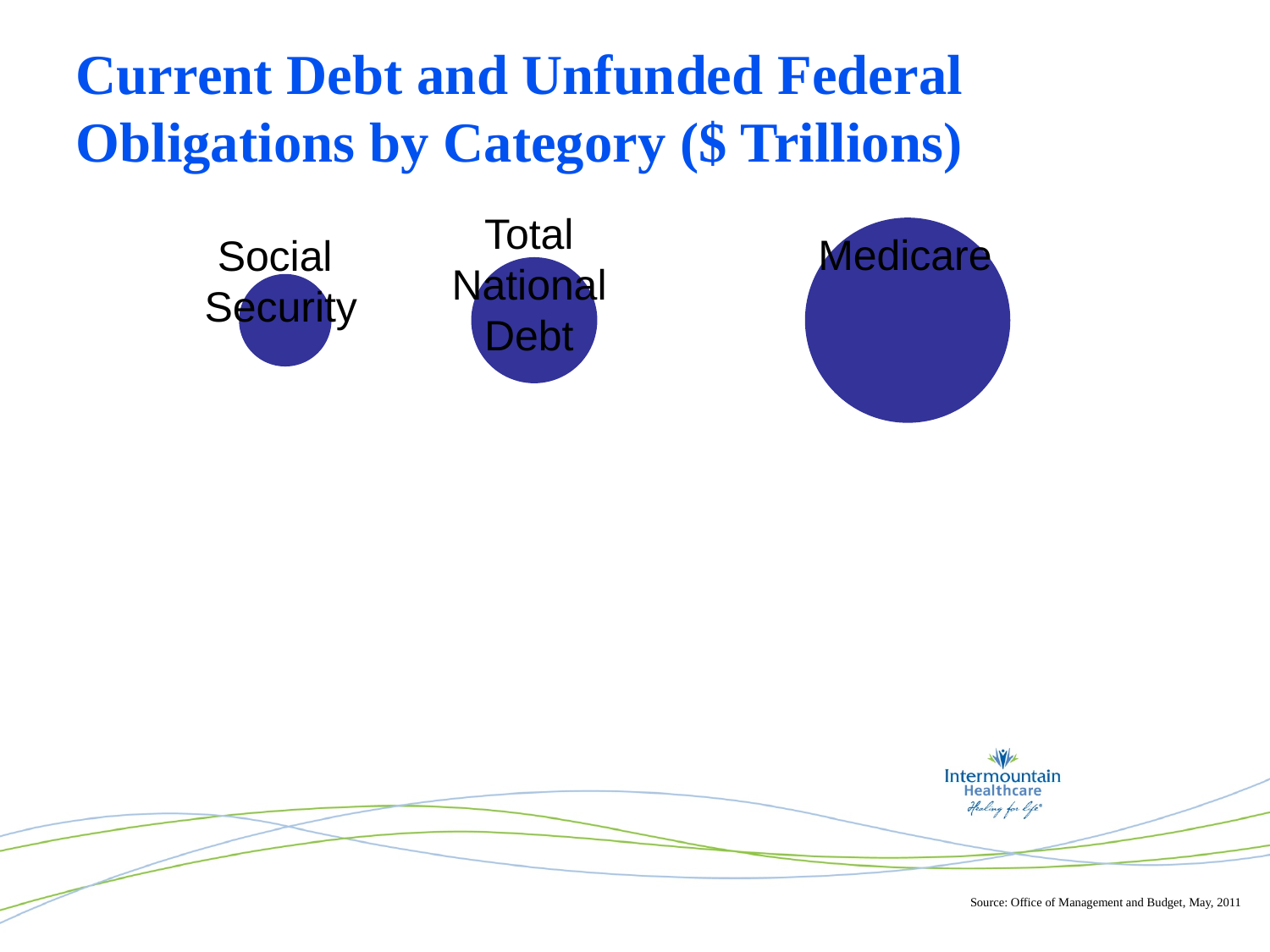
What is the title of the chart on the slide? Current Debt and Unfunded Federal Obligations by Category ($ Trillions) What unit does the chart title say the values are in? $ Trillions Which category has the largest bubble on the chart? Medicare Which category has the smallest bubble on the chart? Social Security Which is larger on the chart, Total National Debt or Social Security? Total National Debt How many categories (bubbles) are plotted on the chart? 3 What kind of chart is shown on the slide? Bubble chart Which is larger on the chart, Medicare or Social Security? Medicare Which is larger on the chart, Medicare or Total National Debt? Medicare